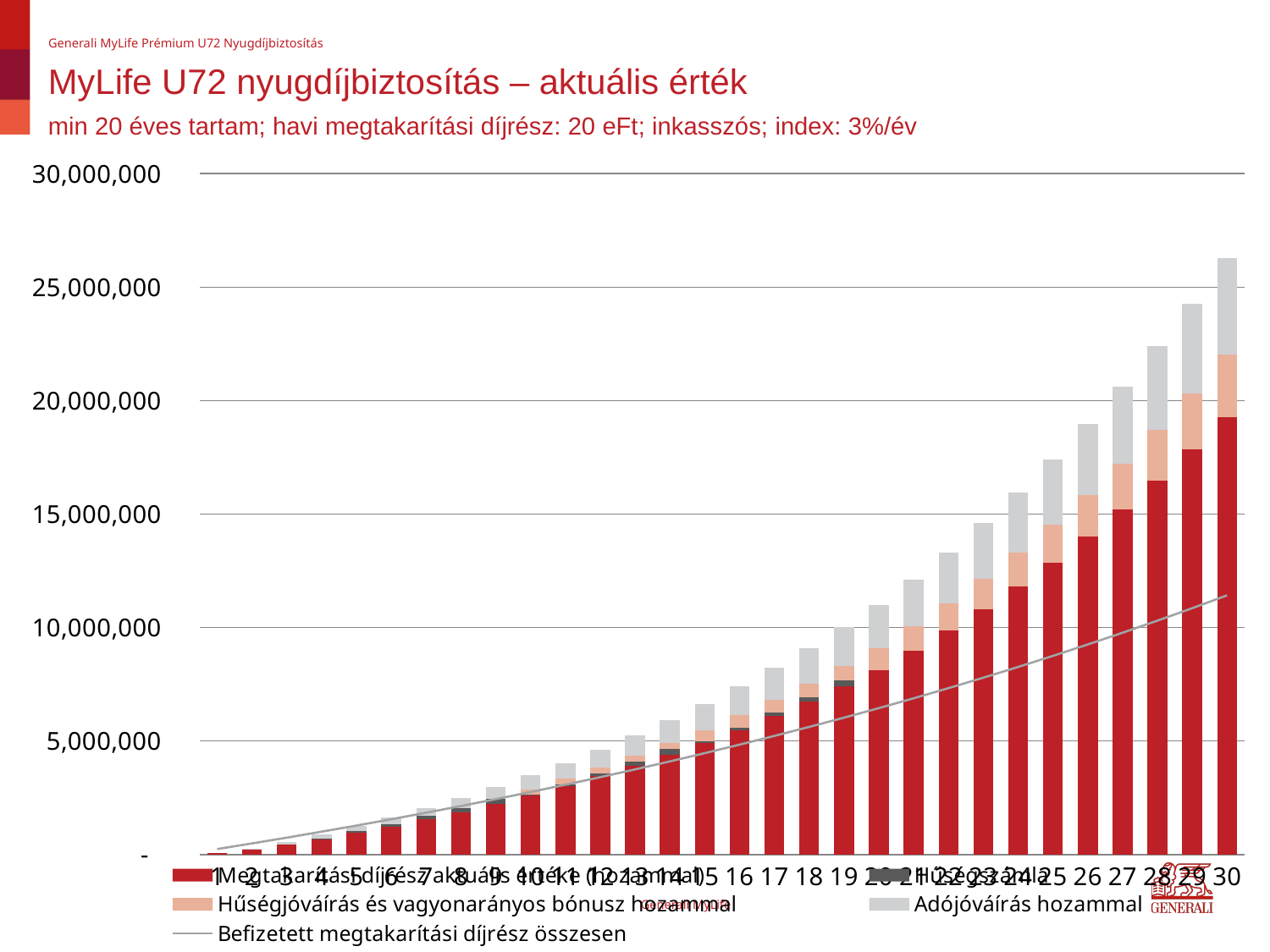
Is the total of the stacked bar for year 30 greater or less than 25,000,000? greater Which year has the tallest stacked bar? 30 Is the total of the stacked bar for year 25 greater or less than 15,000,000? greater Do the stacked bar totals rise or fall as the years increase along the x axis? Rise Is the total of the stacked bar for year 10 greater or less than 5,000,000? less What is the highest value shown on the vertical axis? 30,000,000 How many years (categories) are plotted along the x axis? 30 Which year has the shortest stacked bar? 1 Which stacked bar is taller, year 20 or year 30? 30 What kind of chart is shown on the slide? Stacked bar chart with a line What is the title of the chart on the slide? MyLife U72 nyugdíjbiztosítás – aktuális érték